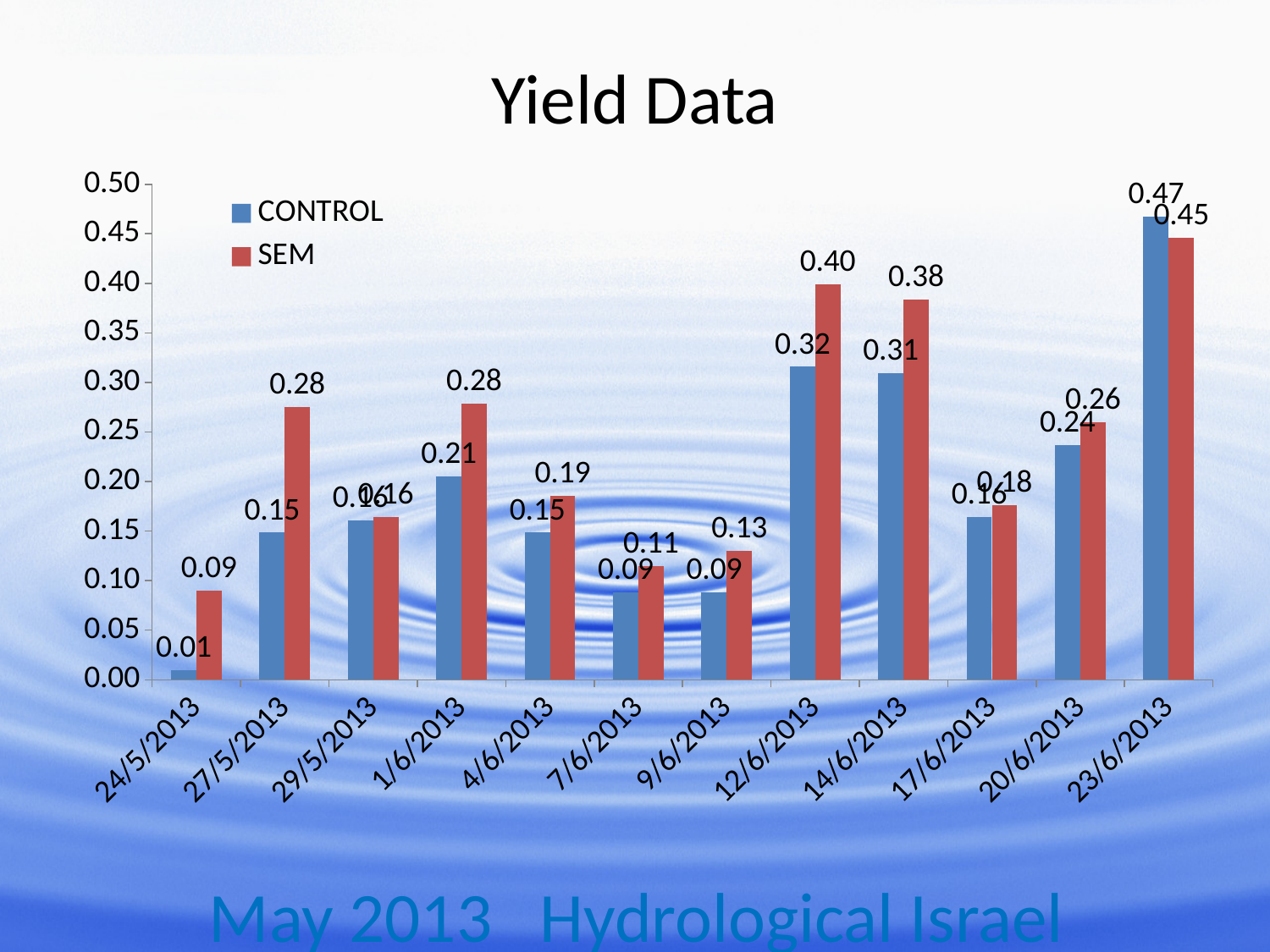
What is the CONTROL value on 12/6/2013? 0.32 On 23/6/2013, which series has the larger value, CONTROL or SEM? CONTROL What is the SEM value on 27/5/2013? 0.28 What kind of chart is shown on the slide? bar chart How many series does the legend list? 2 What is the title of the chart? Yield Data On which date is the SEM value highest? 23/6/2013 Is the SEM value on 14/6/2013 greater or less than 0.35? greater What is the CONTROL value on 24/5/2013? 0.01 How many dates are shown on the x axis? 12 What is the difference between the SEM and CONTROL values on 12/6/2013? 0.08 On which date is the CONTROL value lowest? 24/5/2013